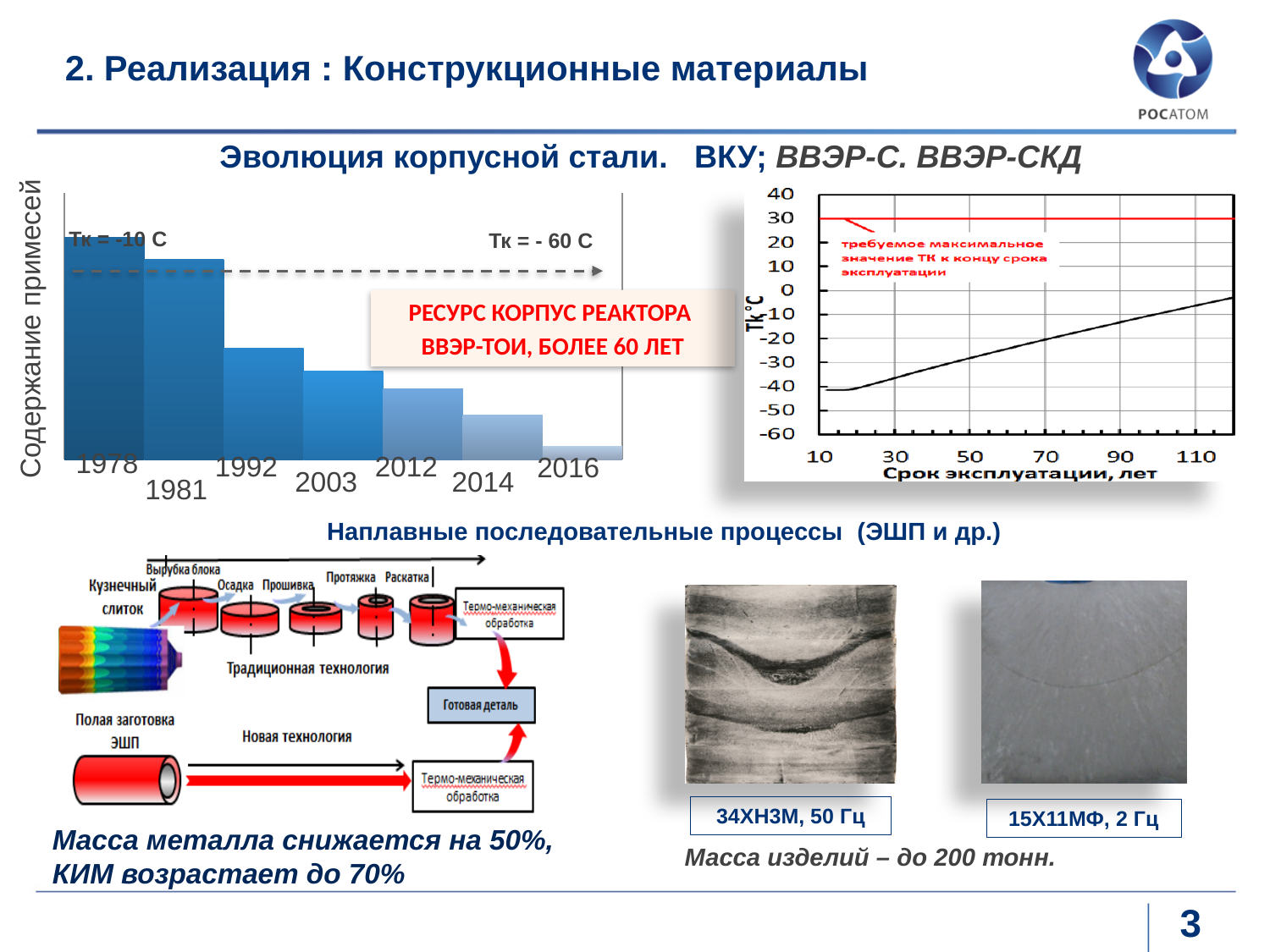
What kind of chart is the left chart showing 'Содержание примесей' by year? bar chart In the left bar chart, how many years (bars) are shown along the x axis? 7 In the left bar chart, which bar is taller: 1981 or 2003? 1981 In the left bar chart, do the bar heights rise or fall from 1978 to 2016? fall In the right line chart, is the black line's value at 110 years greater or less than 0? less What is the x-axis label of the right line chart? Срок эксплуатации, лет What is the y-axis label of the left bar chart? Содержание примесей In the right line chart, at what Tк value does the red horizontal line (required maximum Tк) sit? 30 In the left bar chart, which year has the lowest bar? 2016 In the left bar chart, which year has the highest bar? 1978 What kind of chart is the right chart with 'Срок эксплуатации, лет' on the x axis? line chart In the right line chart, does the black line rise or fall as the operating life (Срок эксплуатации) increases? rise